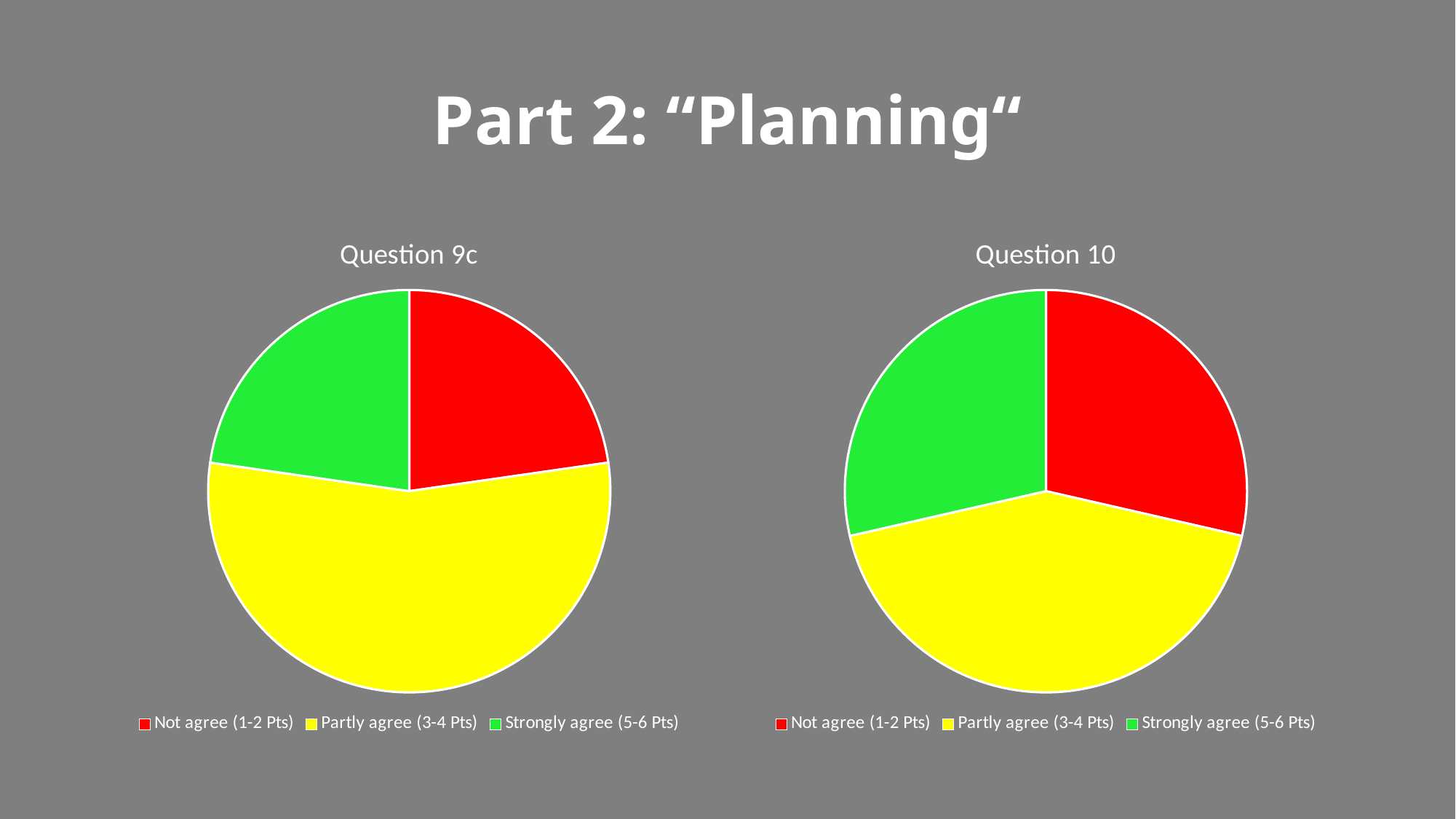
What is the title of the slide? Part 2: "Planning" How many slices does the "Question 10" pie chart have? 3 In the "Question 10" chart, which category has the largest slice? Partly agree (3-4 Pts) How many entries does the legend of the "Question 9c" chart list? 3 In the "Question 9c" chart, which slice is larger: Partly agree (3-4 Pts) or Not agree (1-2 Pts)? Partly agree (3-4 Pts) In the "Question 10" chart, which slice is larger: Strongly agree (5-6 Pts) or Partly agree (3-4 Pts)? Partly agree (3-4 Pts) In the "Question 9c" chart, which category has the largest slice? Partly agree (3-4 Pts) How many slices does the "Question 9c" pie chart have? 3 In the "Question 10" chart, what colour represents Strongly agree (5-6 Pts)? green What kind of chart is the "Question 9c" chart? pie chart What kind of chart is the "Question 10" chart? pie chart